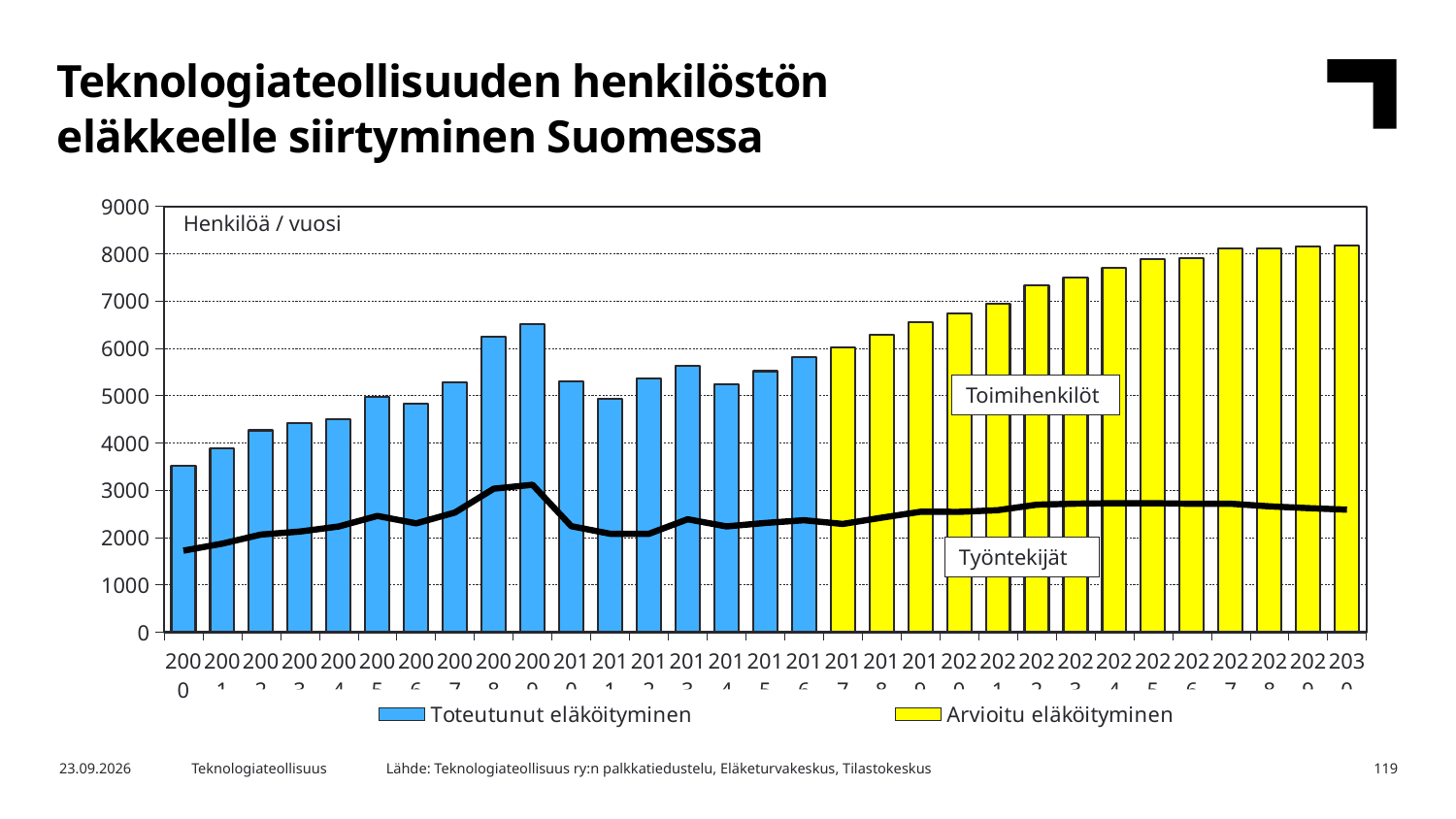
Is the value for 2000 greater or less than 4000? less Is the value for 2016 greater or less than 6000? less Is the value for 2009 greater or less than 6000? greater What kind of chart is shown on the slide? combination bar and line chart Which year has the lowest bar? 2000 What unit label is shown at the top left of the plot area? Henkilöä / vuosi Which is larger, the bar for 2009 or the bar for 2010? 2009 Among the blue 'Toteutunut eläköityminen' bars, which year is the highest? 2009 Do the yellow 'Arvioitu eläköityminen' bars rise or fall from 2017 to 2030? rise How many years (bars) are plotted along the x axis? 31 How many series does the legend list? 2